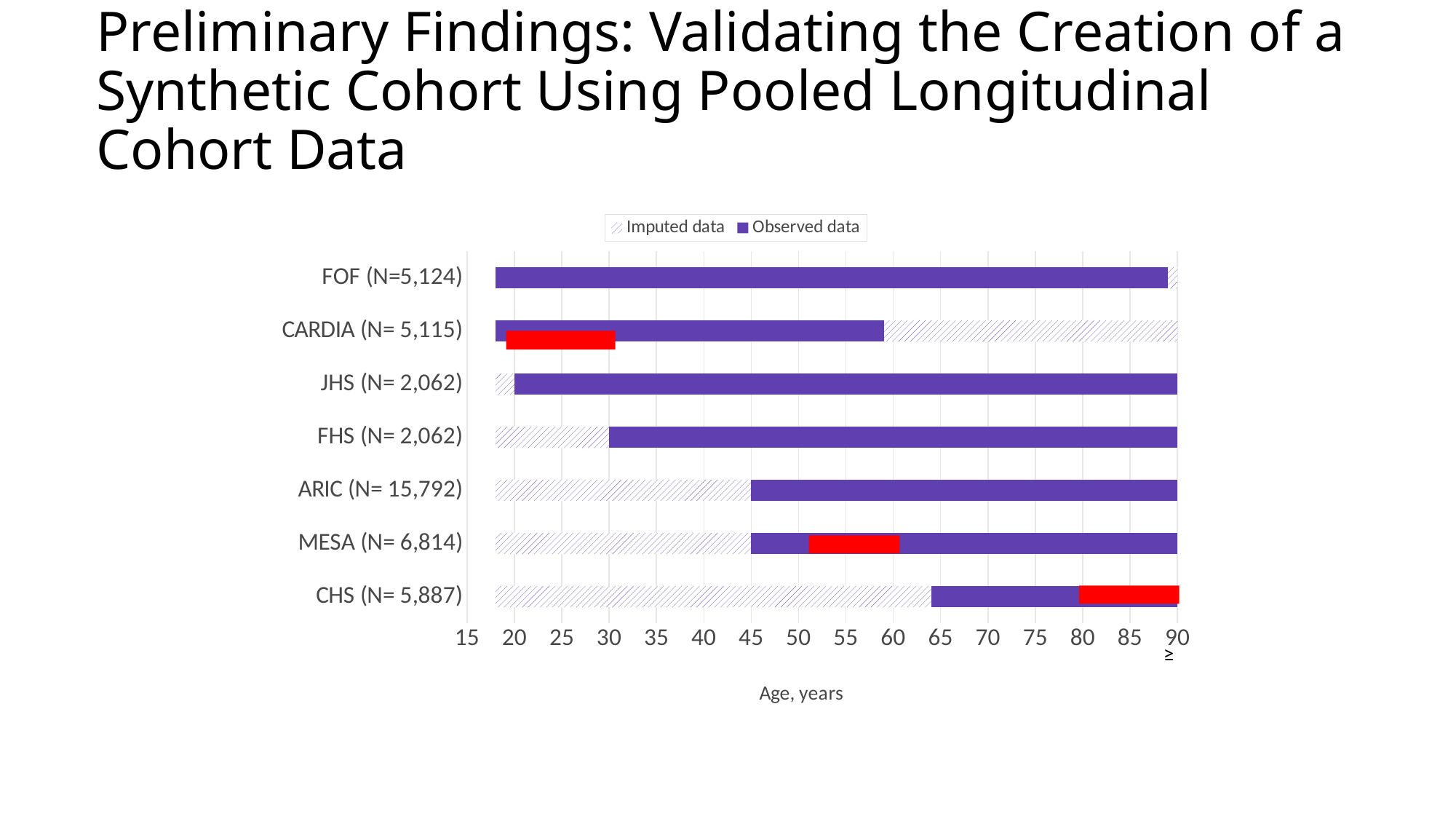
What kind of chart is shown on the slide? Bar chart Does the observed data for FHS begin at an age greater or less than 35? less Does the observed data for ARIC begin at an age greater or less than 40? greater Which cohort's observed data begins at an older age, CHS or MESA? CHS What are the two series named in the chart legend? Imputed data and Observed data What is the title of the horizontal axis of the chart? Age, years Which cohort has the largest sample size (N) according to the category labels? ARIC (N= 15,792) How many cohorts are listed on the vertical axis of the chart? 7 Does the observed data for CARDIA end at an age greater or less than 55? greater How many series does the chart legend list? 2